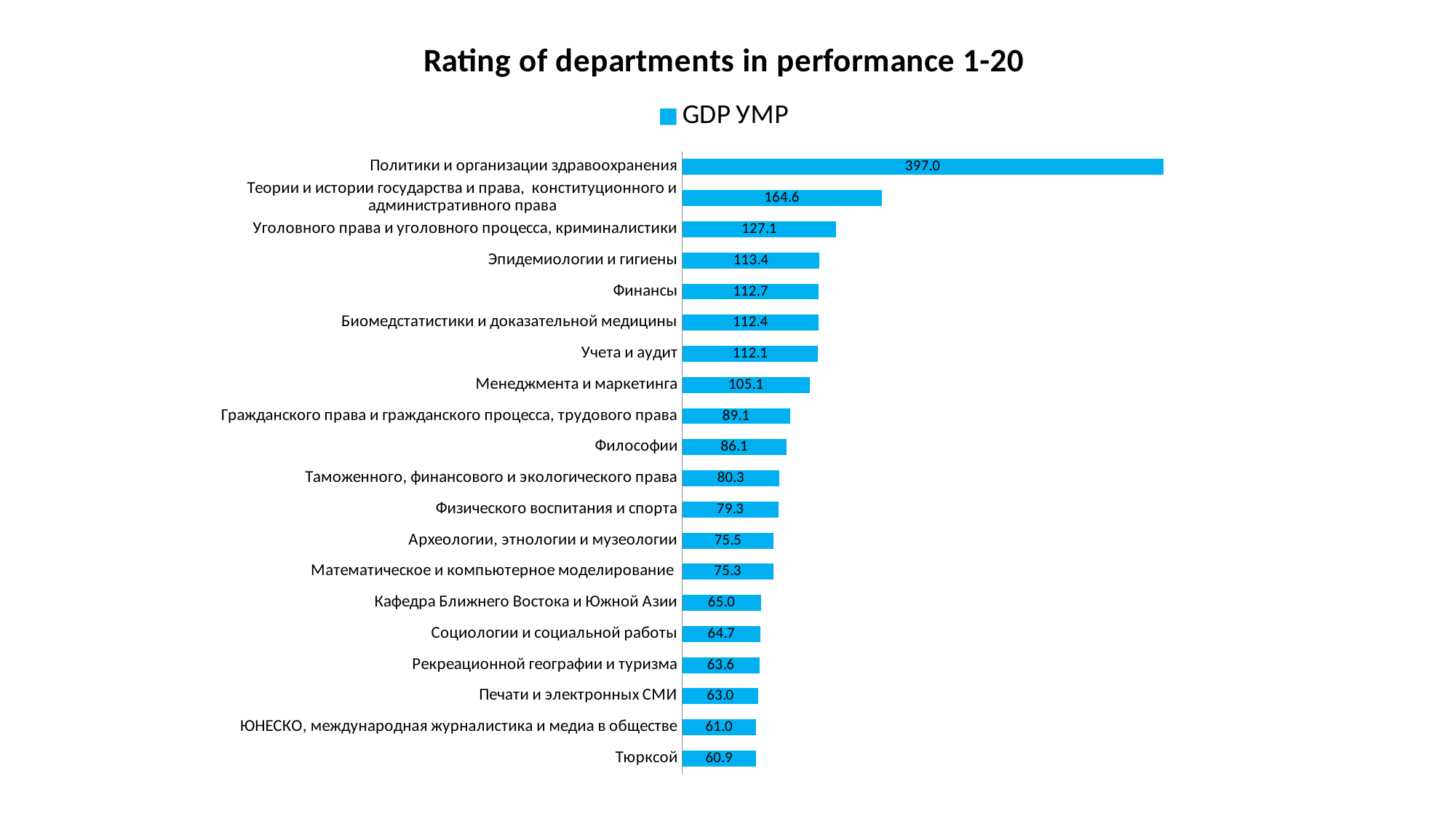
Which department has the highest value? Политики и организации здравоохранения What is the value for Тюрксой? 60.9 What is the title of the chart? Rating of departments in performance 1-20 What kind of chart is shown on the slide? Bar chart How many departments are shown in the chart? 20 What is the value for Философии? 86.1 What is the value for Финансы? 112.7 What is the difference between the values for Политики и организации здравоохранения and Уголовного права и уголовного процесса, криминалистики? 269.9 Which department has the lowest value? Тюрксой How many series does the legend list? 1 Which has a larger value, Менеджмента и маркетинга or Эпидемиологии и гигиены? Эпидемиологии и гигиены What is the name of the series in the legend? GDP УМР